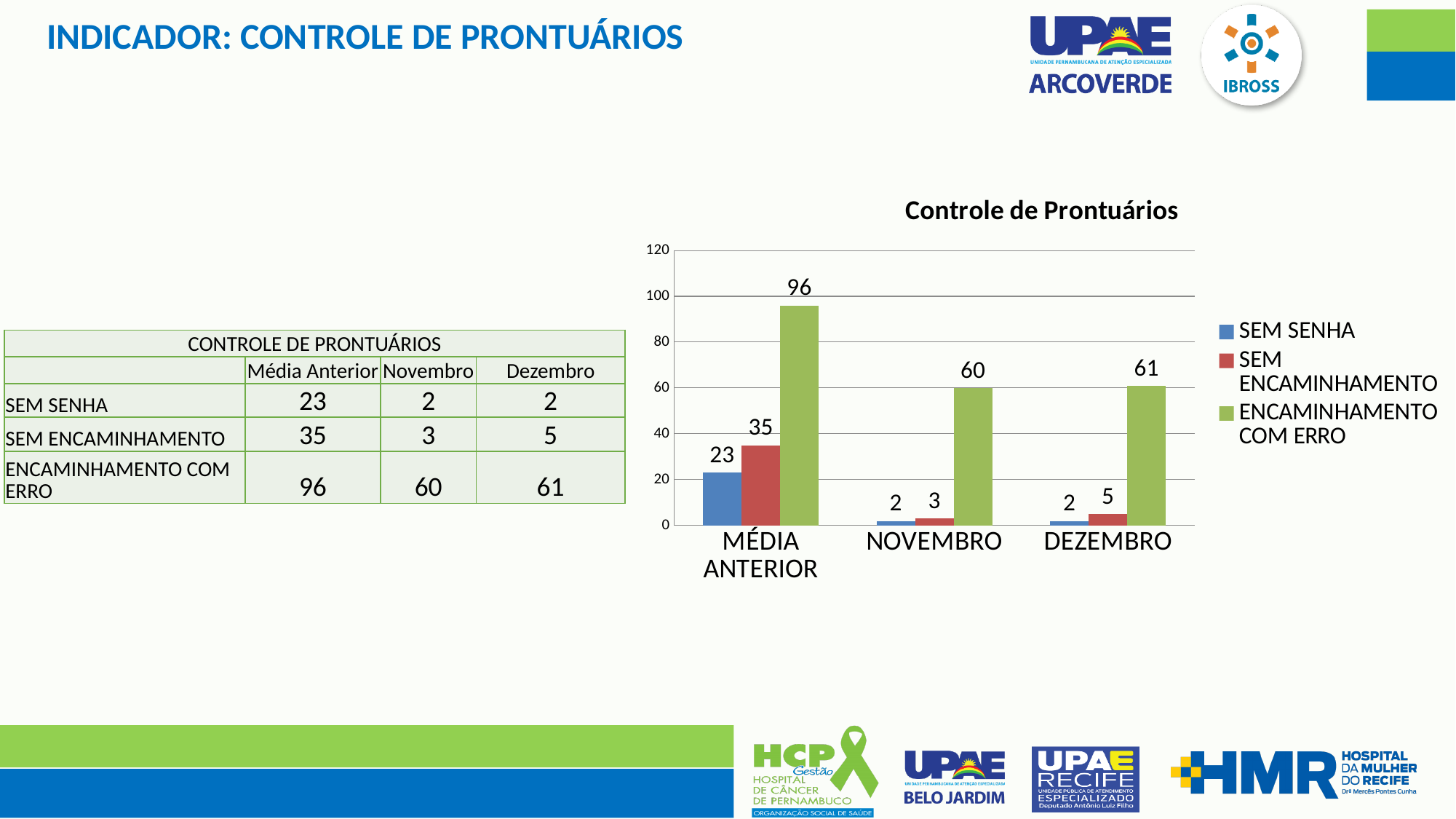
Which category has the lowest value for SEM ENCAMINHAMENTO? NOVEMBRO What is the difference between ENCAMINHAMENTO COM ERRO for MÉDIA ANTERIOR and for NOVEMBRO? 36 Which is larger: SEM SENHA for MÉDIA ANTERIOR or SEM ENCAMINHAMENTO for MÉDIA ANTERIOR? SEM ENCAMINHAMENTO What is the value of ENCAMINHAMENTO COM ERRO for MÉDIA ANTERIOR? 96 How many series does the legend list? 3 What is the value of SEM SENHA for NOVEMBRO? 2 How many categories are shown on the x axis? 3 Which category has the highest value for ENCAMINHAMENTO COM ERRO? MÉDIA ANTERIOR What kind of chart is shown? bar chart What is the title of the chart? Controle de Prontuários What is the value of SEM ENCAMINHAMENTO for DEZEMBRO? 5 Does the value of ENCAMINHAMENTO COM ERRO rise or fall from MÉDIA ANTERIOR to NOVEMBRO? fall